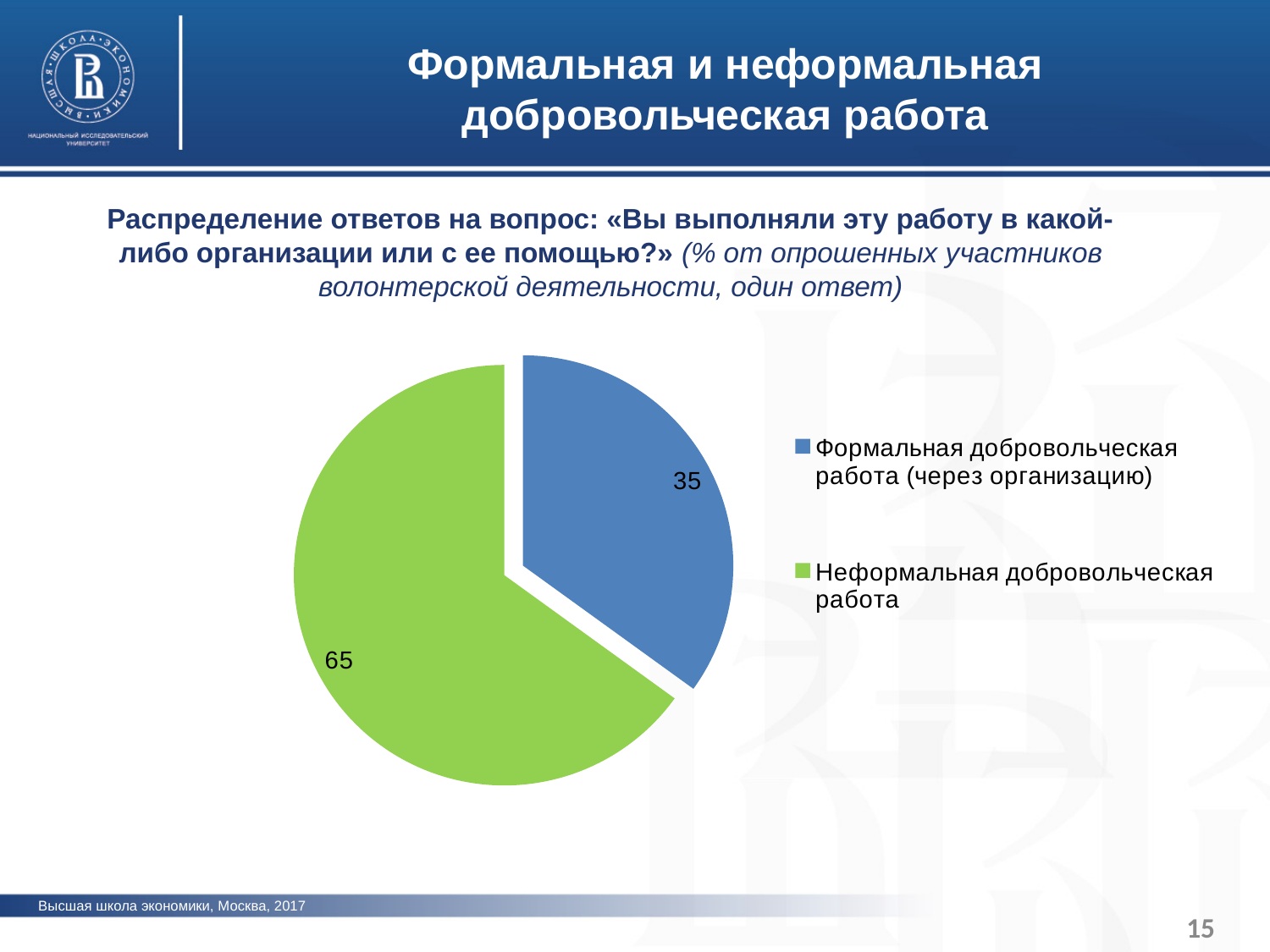
Which category has the smallest slice of the pie? Формальная добровольческая работа (через организацию) What type of chart is shown on the slide? pie chart What share of the pie does «Неформальная добровольческая работа» represent? 65% What is the value for «Неформальная добровольческая работа»? 65 How many slices does the pie chart have? 2 What colour is the slice for «Неформальная добровольческая работа»? green What is the value for «Формальная добровольческая работа (через организацию)»? 35 What colour is the slice for «Формальная добровольческая работа (через организацию)»? blue Which is larger: the value for «Формальная добровольческая работа (через организацию)» or for «Неформальная добровольческая работа»? Неформальная добровольческая работа What is the difference between the values for «Неформальная добровольческая работа» and «Формальная добровольческая работа (через организацию)»? 30 Which category has the largest slice of the pie? Неформальная добровольческая работа How many entries does the legend list? 2